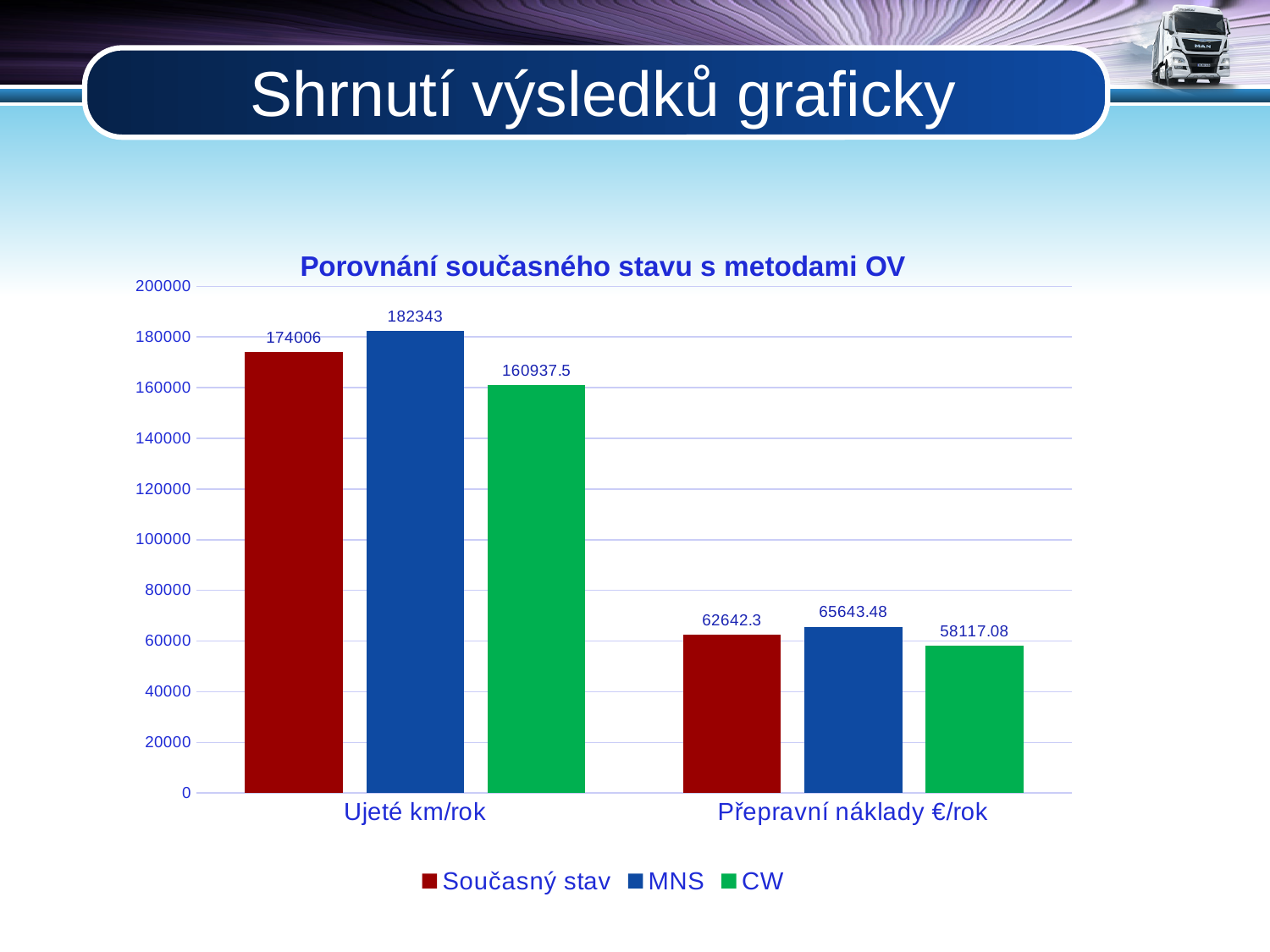
Which series has the highest value in the Ujeté km/rok category? MNS Which series has the lowest value in the Přepravní náklady €/rok category? CW What is the title of the chart? Porovnání současného stavu s metodami OV How many series does the legend list? 3 What is the value for CW in the Přepravní náklady €/rok category? 58117.08 What is the difference between the Současný stav and CW values in the Přepravní náklady €/rok category? 4525.22 What is the difference between the MNS and Současný stav values in the Ujeté km/rok category? 8337 Is the value for CW in the Ujeté km/rok category greater or less than 180000? less What is the value for Současný stav in the Přepravní náklady €/rok category? 62642.3 What kind of chart is shown on the slide? bar chart What is the value for MNS in the Ujeté km/rok category? 182343 Which is larger in the Přepravní náklady €/rok category: MNS or Současný stav? MNS